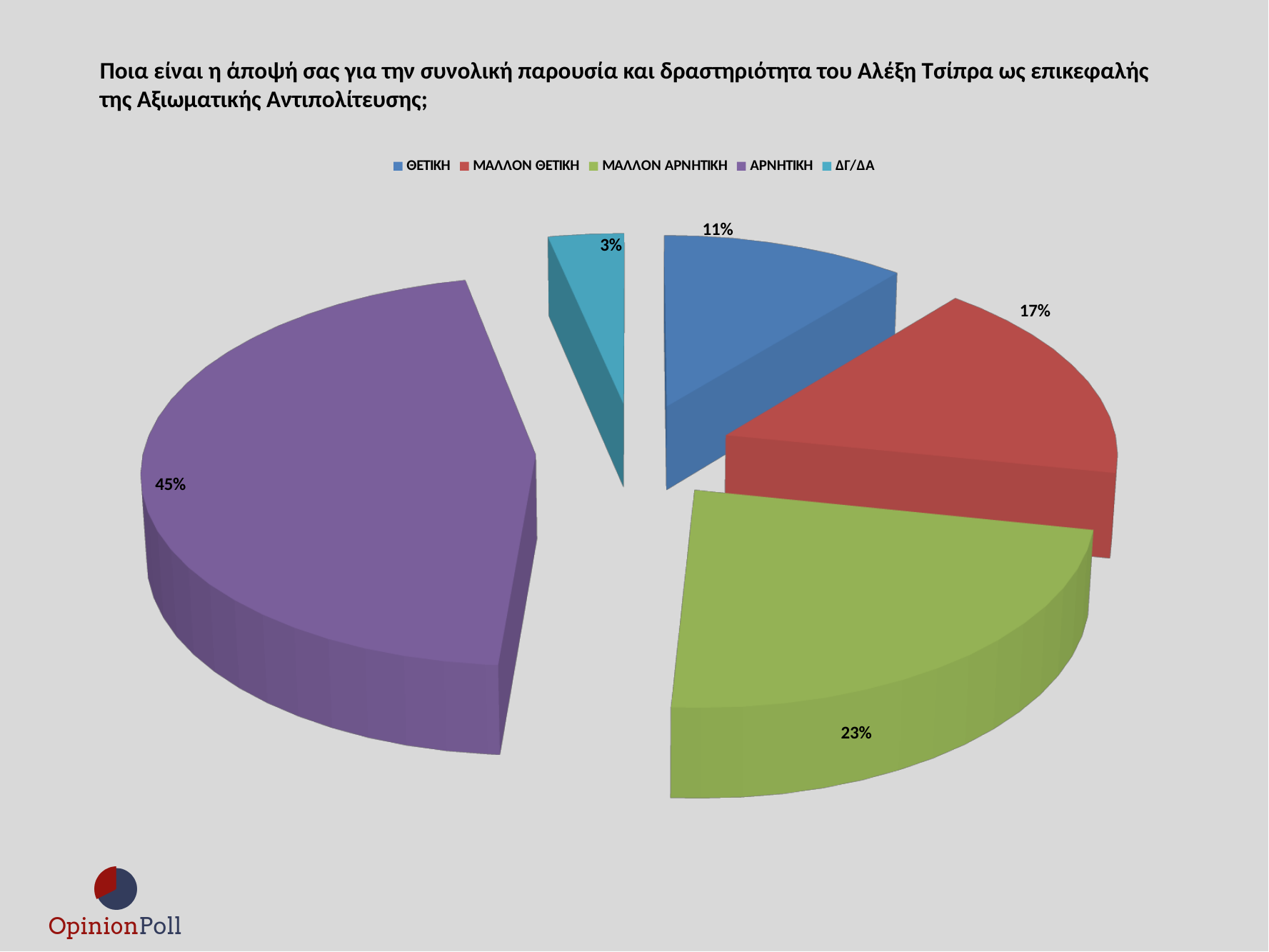
What percentage of respondents answered ΘΕΤΙΚΗ? 11% What percentage of respondents answered ΜΑΛΛΟΝ ΘΕΤΙΚΗ? 17% Which is larger, the share for ΜΑΛΛΟΝ ΘΕΤΙΚΗ or the share for ΘΕΤΙΚΗ? ΜΑΛΛΟΝ ΘΕΤΙΚΗ What percentage of respondents answered ΑΡΝΗΤΙΚΗ? 45% How many categories does the legend list? 5 What kind of chart is shown on the slide? Pie chart What percentage of respondents answered ΜΑΛΛΟΝ ΑΡΝΗΤΙΚΗ? 23% What colour is the slice for ΜΑΛΛΟΝ ΑΡΝΗΤΙΚΗ? Green Which response category has the largest share of the pie? ΑΡΝΗΤΙΚΗ What is the difference in percentage points between ΑΡΝΗΤΙΚΗ and ΜΑΛΛΟΝ ΑΡΝΗΤΙΚΗ? 22 Which response category has the smallest share of the pie? ΔΓ/ΔΑ What percentage of respondents answered ΔΓ/ΔΑ? 3%